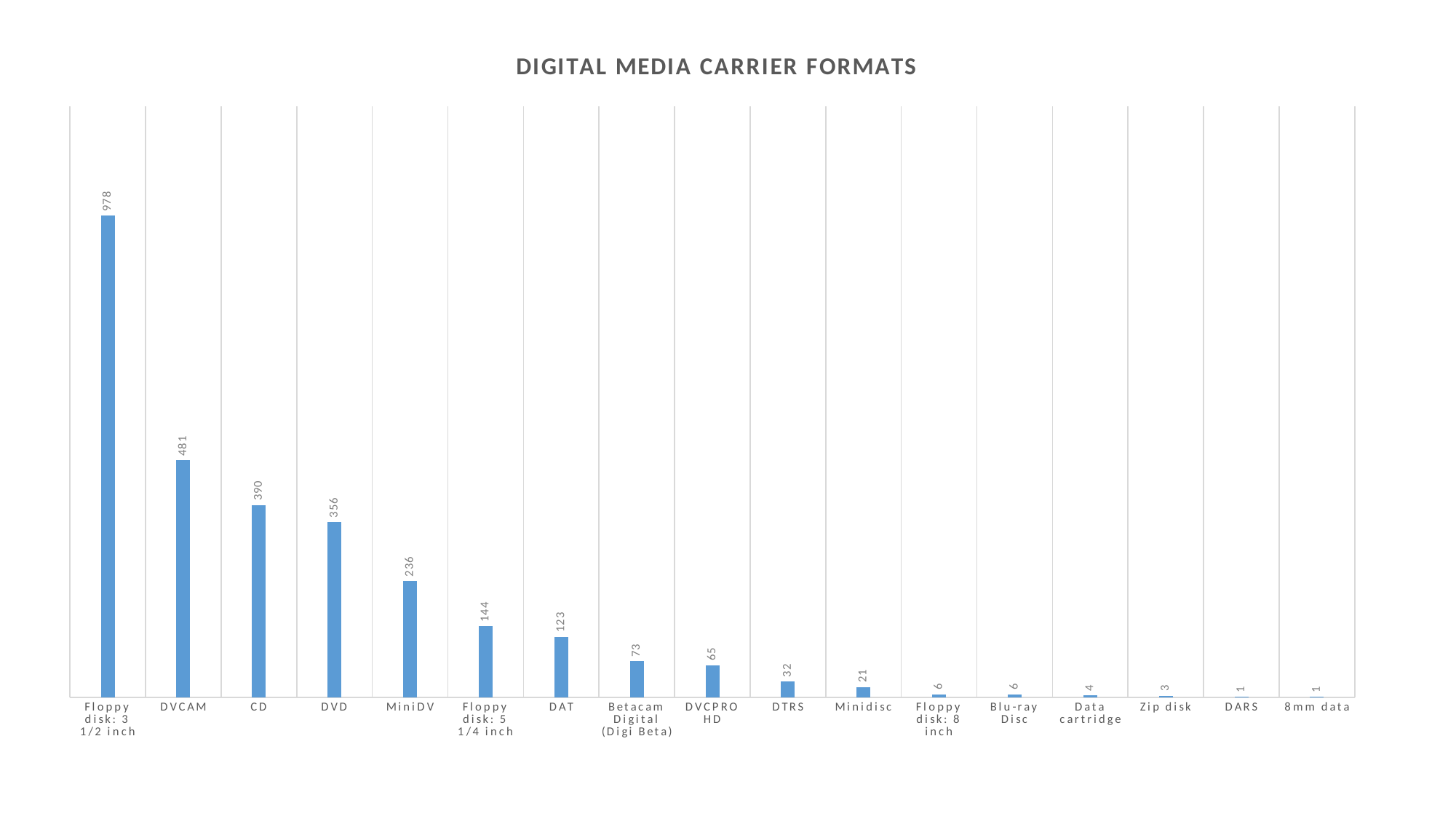
What is the title of the chart? DIGITAL MEDIA CARRIER FORMATS What kind of chart is shown on the slide? Bar chart What is the value for Betacam Digital (Digi Beta)? 73 Which is larger, the value for DTRS or the value for DVCPRO HD? DVCPRO HD Which category has the highest value? Floppy disk: 3 1/2 inch What is the difference between the values for Floppy disk: 3 1/2 inch and DVCAM? 497 What is the difference between the values for CD and DVD? 34 What is the value for DVCAM? 481 What is the value for MiniDV? 236 How many categories are shown on the chart? 17 Which is larger, the value for DAT or the value for Floppy disk: 5 1/4 inch? Floppy disk: 5 1/4 inch What is the value for Zip disk? 3